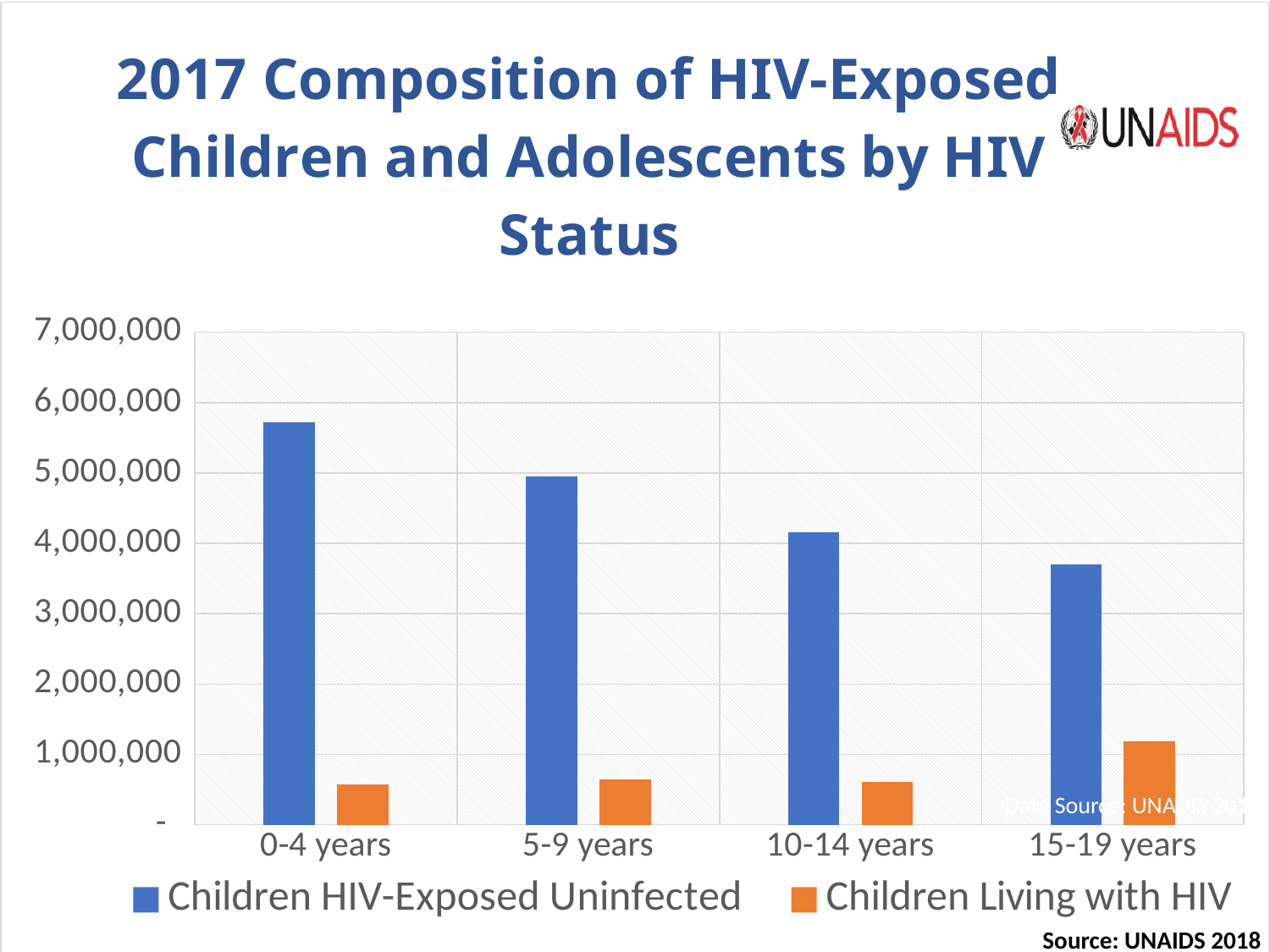
Which age group has the lowest value for Children HIV-Exposed Uninfected? 15-19 years Is the value for Children HIV-Exposed Uninfected in the 0-4 years group greater or less than 5,000,000? greater What kind of chart is shown on the slide? Bar chart Which age group has the highest value for Children Living with HIV? 15-19 years Is the value for Children HIV-Exposed Uninfected in the 15-19 years group greater or less than 4,000,000? less Which age group has the highest value for Children HIV-Exposed Uninfected? 0-4 years How many series does the legend list? 2 Which series is shown in orange in the legend? Children Living with HIV Do the values for Children HIV-Exposed Uninfected rise or fall across the age groups from 0-4 years to 15-19 years? Fall How many age groups are shown on the x axis? 4 Is the value for Children Living with HIV in the 15-19 years group greater or less than 1,000,000? greater In the 10-14 years group, which is larger: Children HIV-Exposed Uninfected or Children Living with HIV? Children HIV-Exposed Uninfected